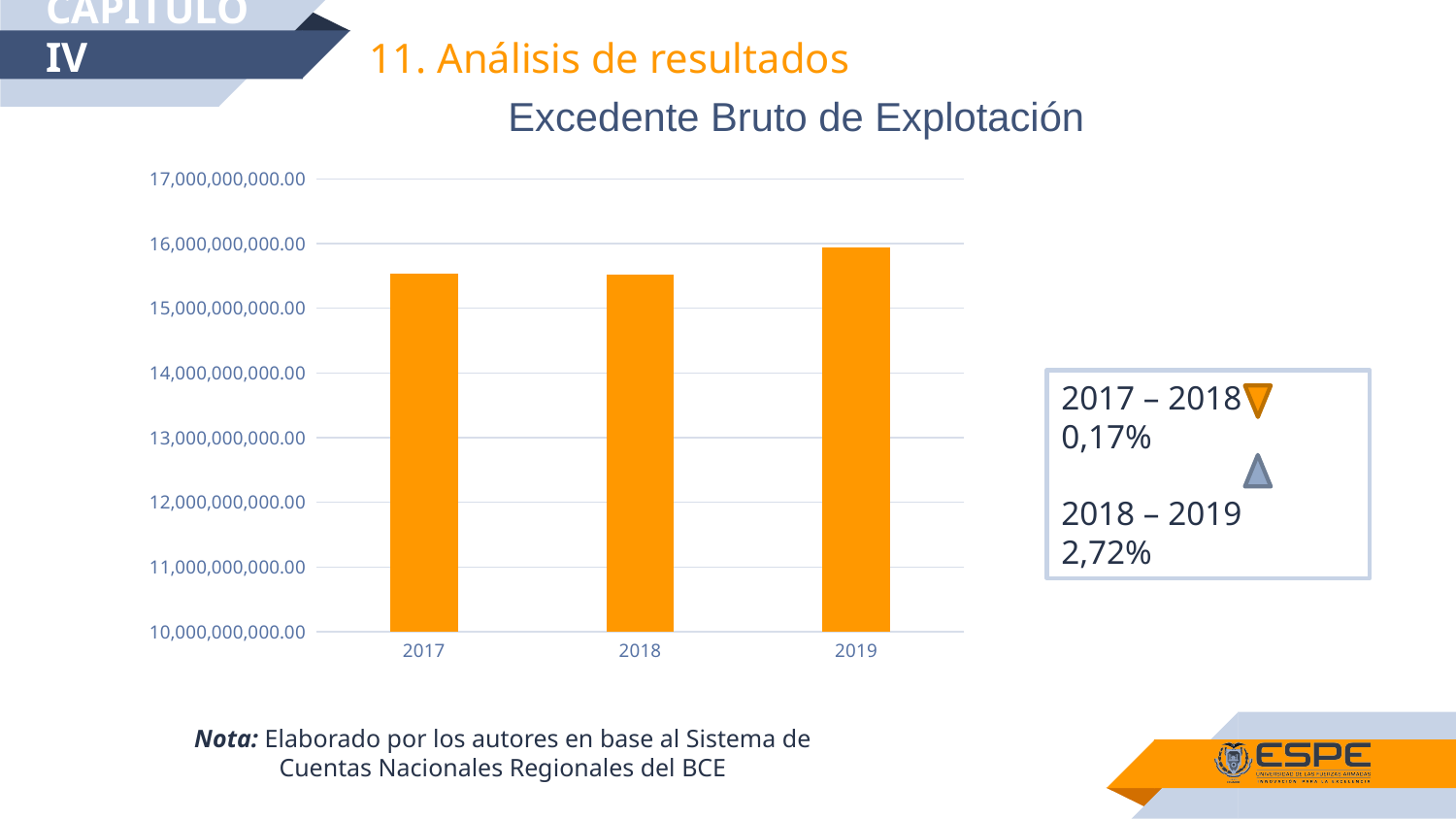
Does the value rise or fall from 2018 to 2019? rise According to the text box next to the chart, what is the percentage change from 2018 to 2019? 2,72% Is the value for 2018 greater or less than 16,000,000,000.00? less What is the title of the chart? Excedente Bruto de Explotación What kind of chart is shown on the slide? bar chart Is the value for 2017 greater or less than 15,000,000,000.00? greater Which is larger, the value for 2018 or the value for 2019? 2019 What is the lowest value shown on the vertical axis of the chart? 10,000,000,000.00 How many years are plotted on the chart? 3 Is the value for 2019 greater or less than 15,000,000,000.00? greater Which year has the highest value on the chart? 2019